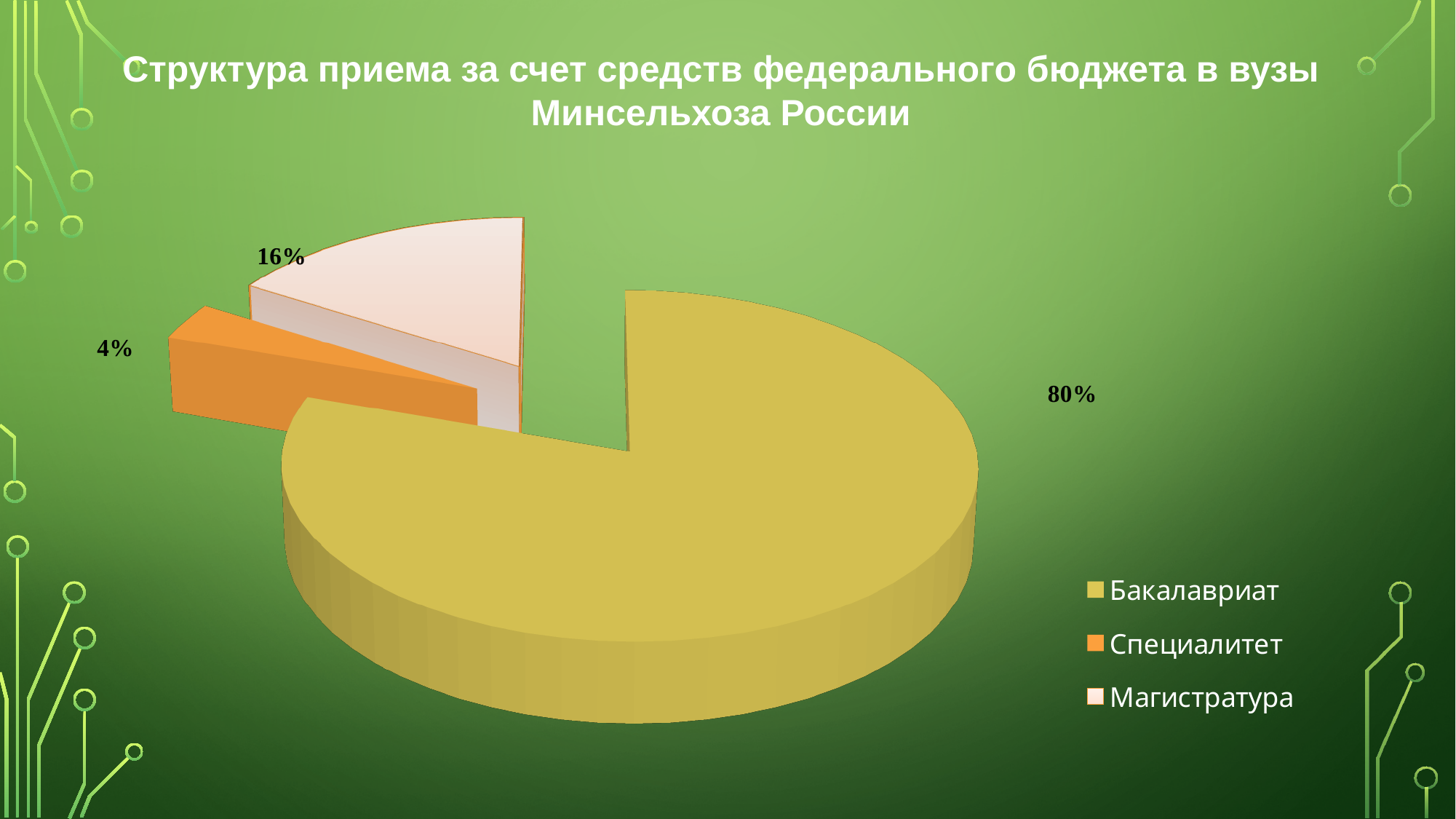
Which is larger, the share for Магистратура or the share for Специалитет? Магистратура Which category has the largest slice of the pie? Бакалавриат Which category has the smallest slice of the pie? Специалитет How many categories are shown in the pie chart? 3 What is the title of the chart? Структура приема за счет средств федерального бюджета в вузы Минсельхоза России What is the difference in percentage points between Магистратура and Специалитет? 12 What share of the pie does Бакалавриат have? 80% What share of the pie does Магистратура have? 16% What kind of chart is shown on the slide? Pie chart What is the difference in percentage points between Бакалавриат and Магистратура? 64 Which category is shown in orange in the legend? Специалитет What share of the pie does Специалитет have? 4%